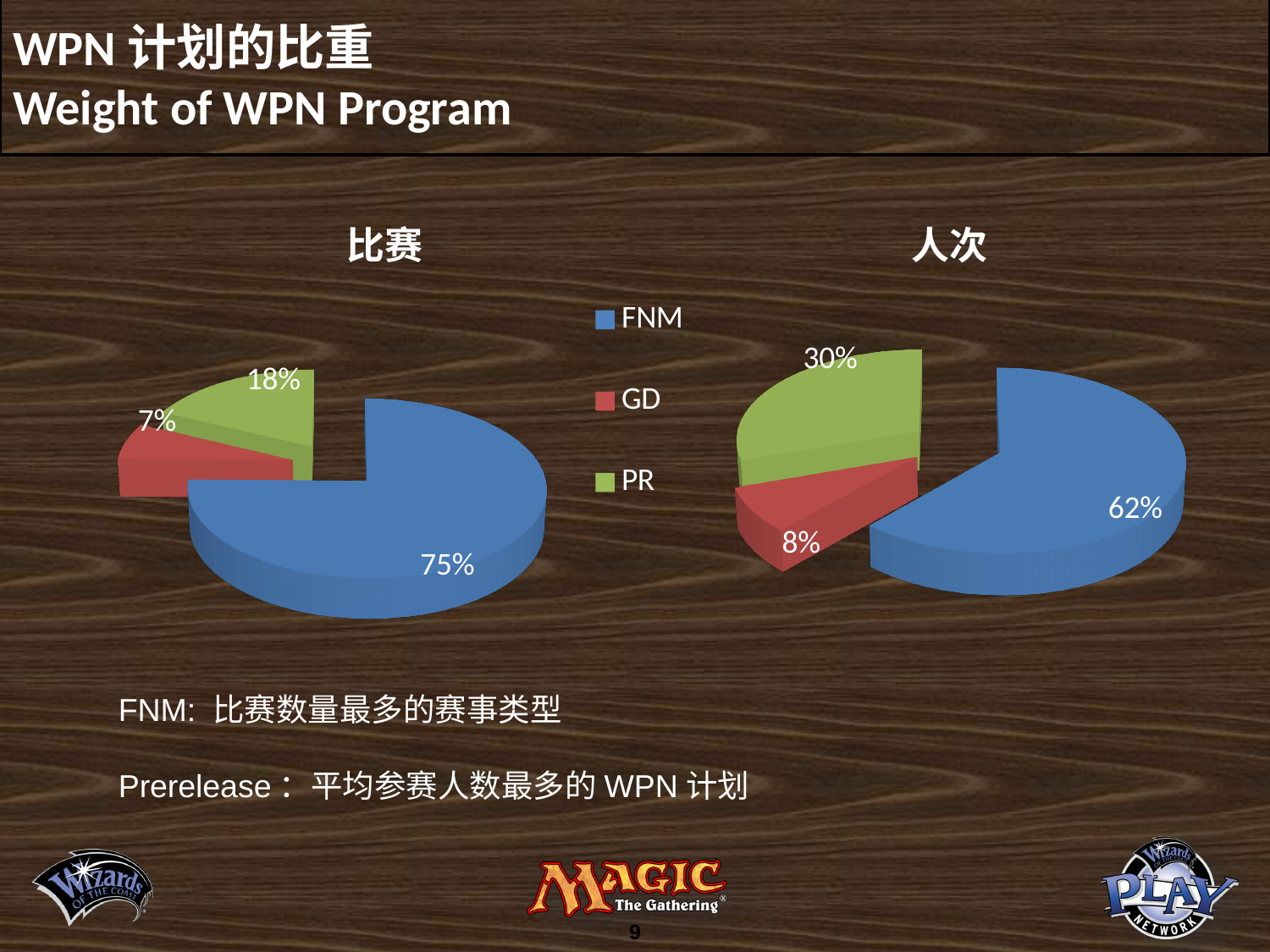
What type of chart is used on this slide? Pie chart In the left pie chart titled 比赛, which category has the largest share? FNM In the right pie chart titled 人次, what share does FNM have? 62% In the right pie chart titled 人次, what share does PR have? 30% In the right pie chart titled 人次, what is the difference between the FNM share and the PR share? 32% In the right pie chart titled 人次, which category has the smallest share? GD In the left pie chart titled 比赛, what share does PR have? 18% In the left pie chart titled 比赛, what share does GD have? 7% How many entries does the legend list? 3 In the right pie chart titled 人次, what share does GD have? 8% In the left pie chart titled 比赛, what share does FNM have? 75% Is the PR share larger in the left chart (比赛) or the right chart (人次)? 人次